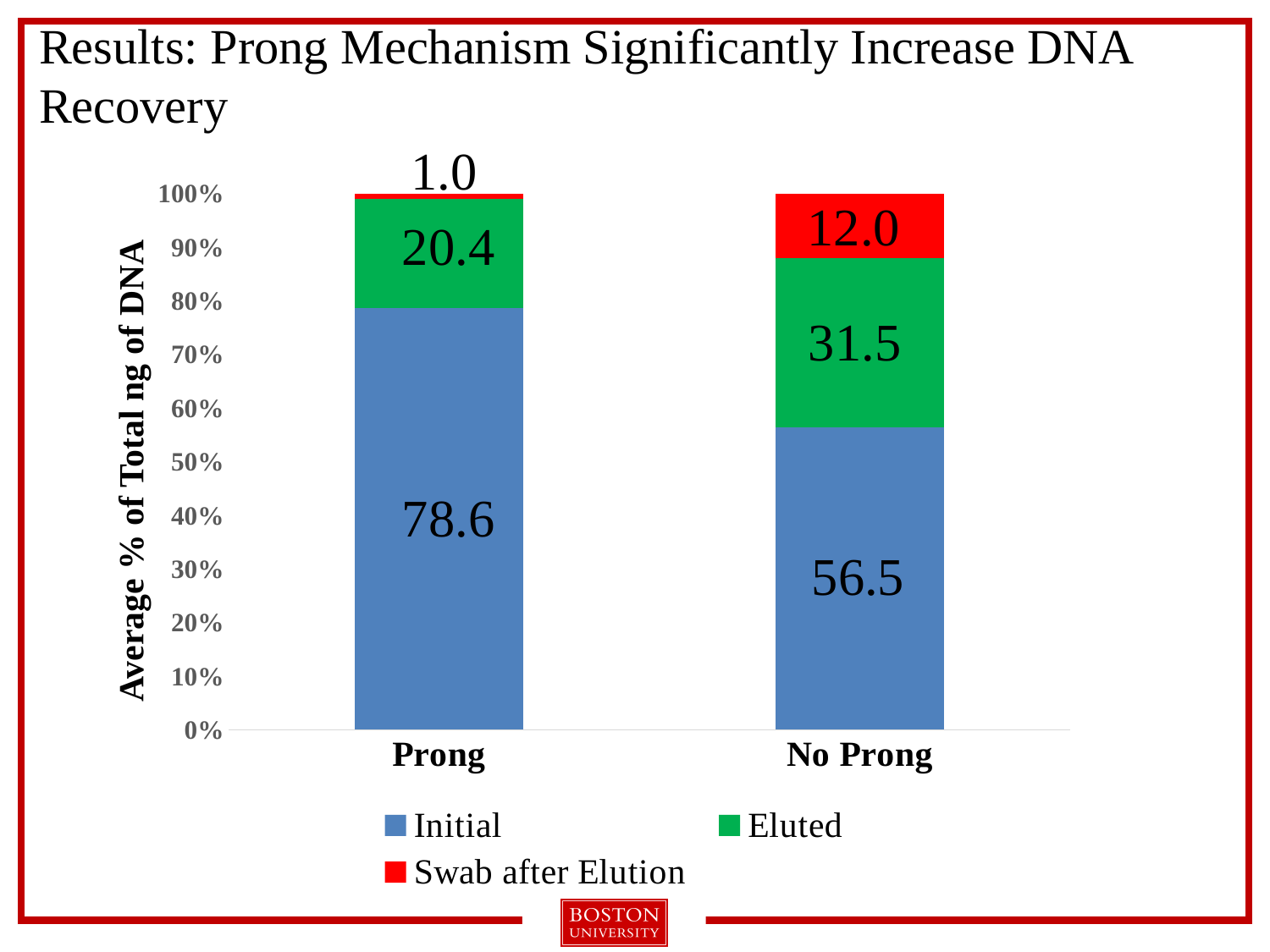
Which category has the higher Initial value, Prong or No Prong? Prong What is the label of the y axis? Average % of Total ng of DNA Which category has the lower Eluted value? Prong How many series does the legend list? 3 How many categories are shown on the x axis? 2 What kind of chart is shown on the slide? Stacked bar chart What is the Initial value for Prong? 78.6 What is the difference between the Swab after Elution values for No Prong and Prong? 11.0 What is the difference between the Initial values for Prong and No Prong? 22.1 What is the Swab after Elution value for No Prong? 12.0 What is the Swab after Elution value for Prong? 1.0 What is the Eluted value for No Prong? 31.5